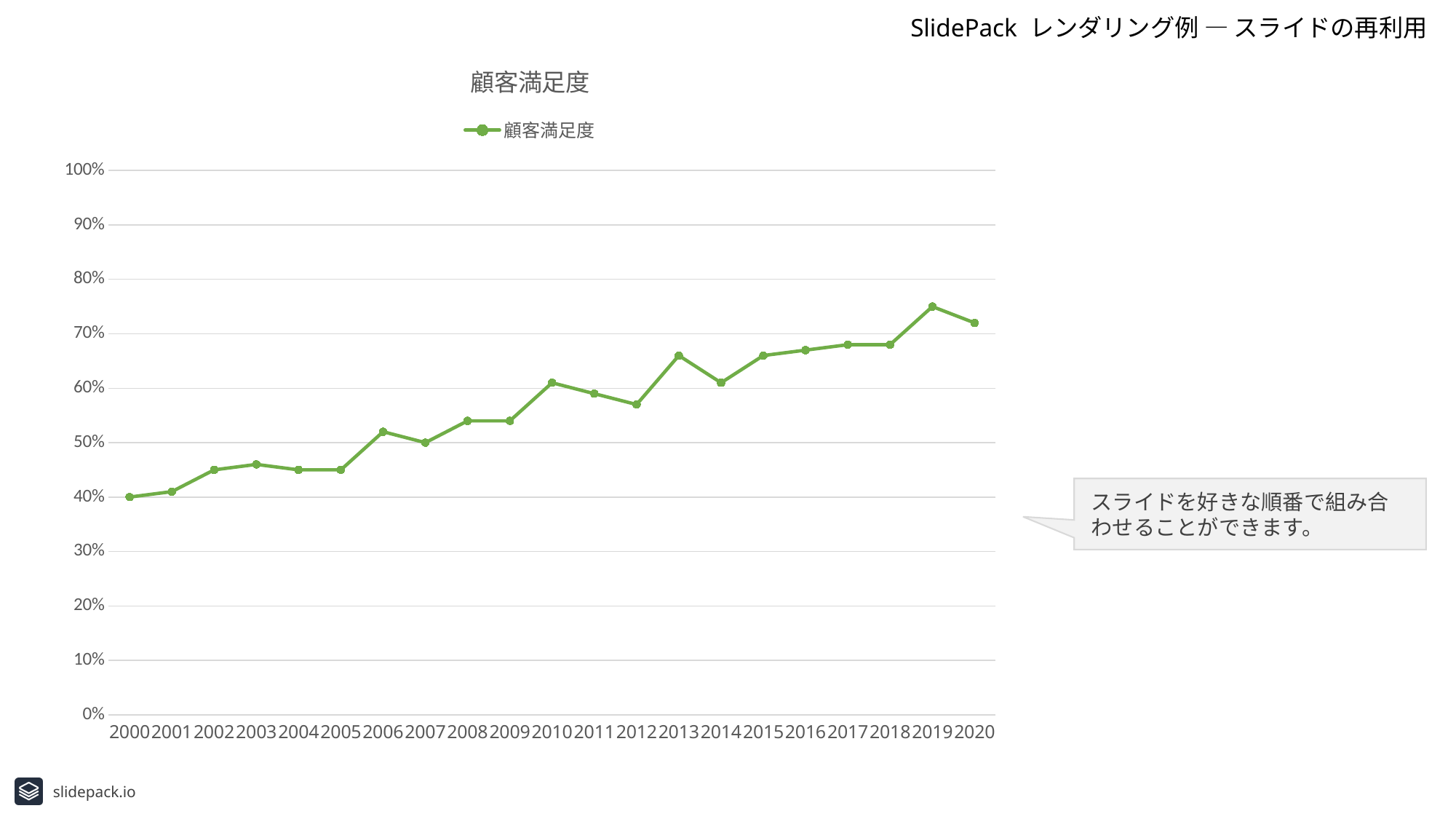
Is the value for 2005 greater or less than 50%? less Is the value for 2013 greater or less than 60%? greater How many series does the legend list? 1 How many years are plotted on the x axis? 21 What is the value for 2000? 40% Do the values generally rise or fall from 2000 to 2020? rise Is the value for 2019 greater or less than 70%? greater Which year has the highest value? 2019 What is the title of the chart? 顧客満足度 What is the value for 2007? 50% What kind of chart is shown on the slide? line chart Which is larger, the value for 2013 or the value for 2014? 2013